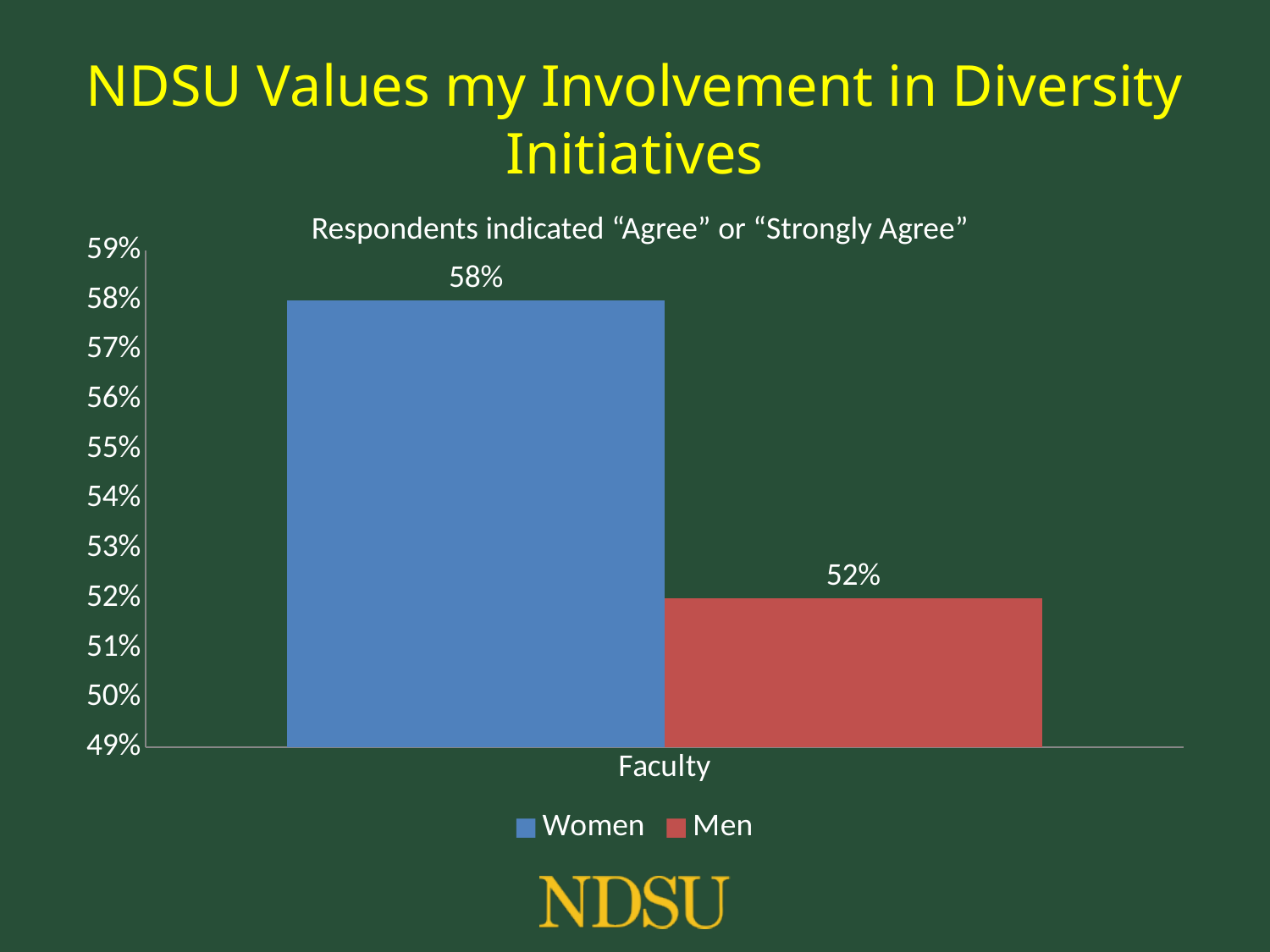
What kind of chart is shown on the slide? Bar chart How many categories are shown on the x axis? 1 Is the value for Men greater or less than 55%? less What is the difference in percentage points between the Women and Men values for Faculty? 6% What is the category label on the x axis? Faculty What percentage of women faculty agreed or strongly agreed that NDSU values their involvement in diversity initiatives? 58% Is the value for Women greater or less than 55%? greater Which series has the lowest value on the chart? Men How many series does the legend list? 2 What percentage of men faculty agreed or strongly agreed that NDSU values their involvement in diversity initiatives? 52% What is the subtitle shown above the chart? Respondents indicated "Agree" or "Strongly Agree" Which series has the higher value for Faculty, Women or Men? Women